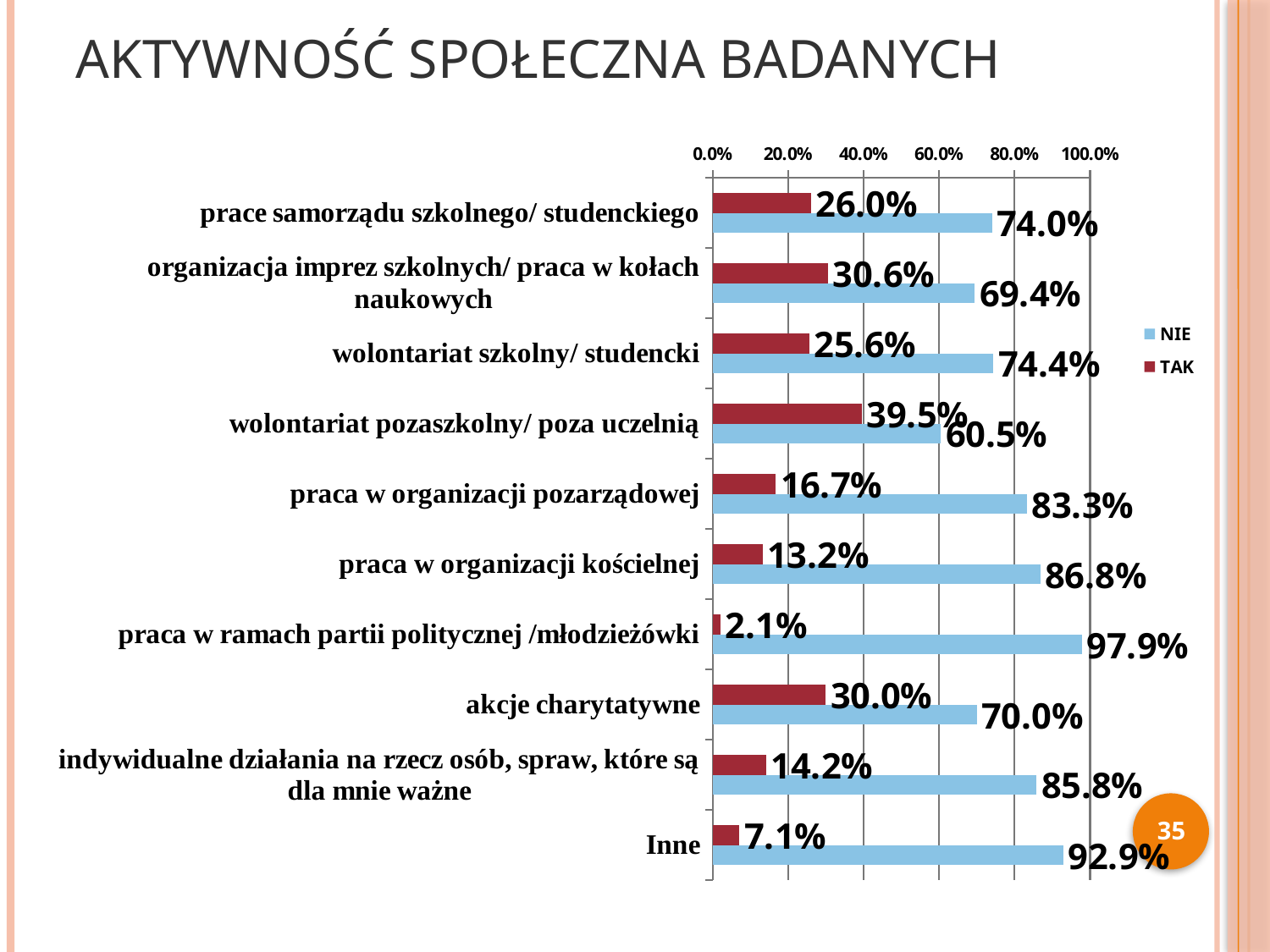
How many categories are shown on the chart? 10 What is the TAK value for "akcje charytatywne"? 30.0% What is the NIE value for "praca w organizacji kościelnej"? 86.8% Which category has the highest TAK value? wolontariat pozaszkolny/ poza uczelnią Which category has the highest NIE value? praca w ramach partii politycznej /młodzieżówki Which category has the lowest TAK value? praca w ramach partii politycznej /młodzieżówki What is the difference between the NIE and TAK values for "prace samorządu szkolnego/ studenckiego"? 48.0% Which is larger: the TAK value for "organizacja imprez szkolnych/ praca w kołach naukowych" or the TAK value for "Inne"? organizacja imprez szkolnych/ praca w kołach naukowych How many series does the legend list? 2 Which colour represents the NIE series in the legend? light blue What kind of chart is shown on the slide? bar chart What is the TAK value for "wolontariat pozaszkolny/ poza uczelnią"? 39.5%